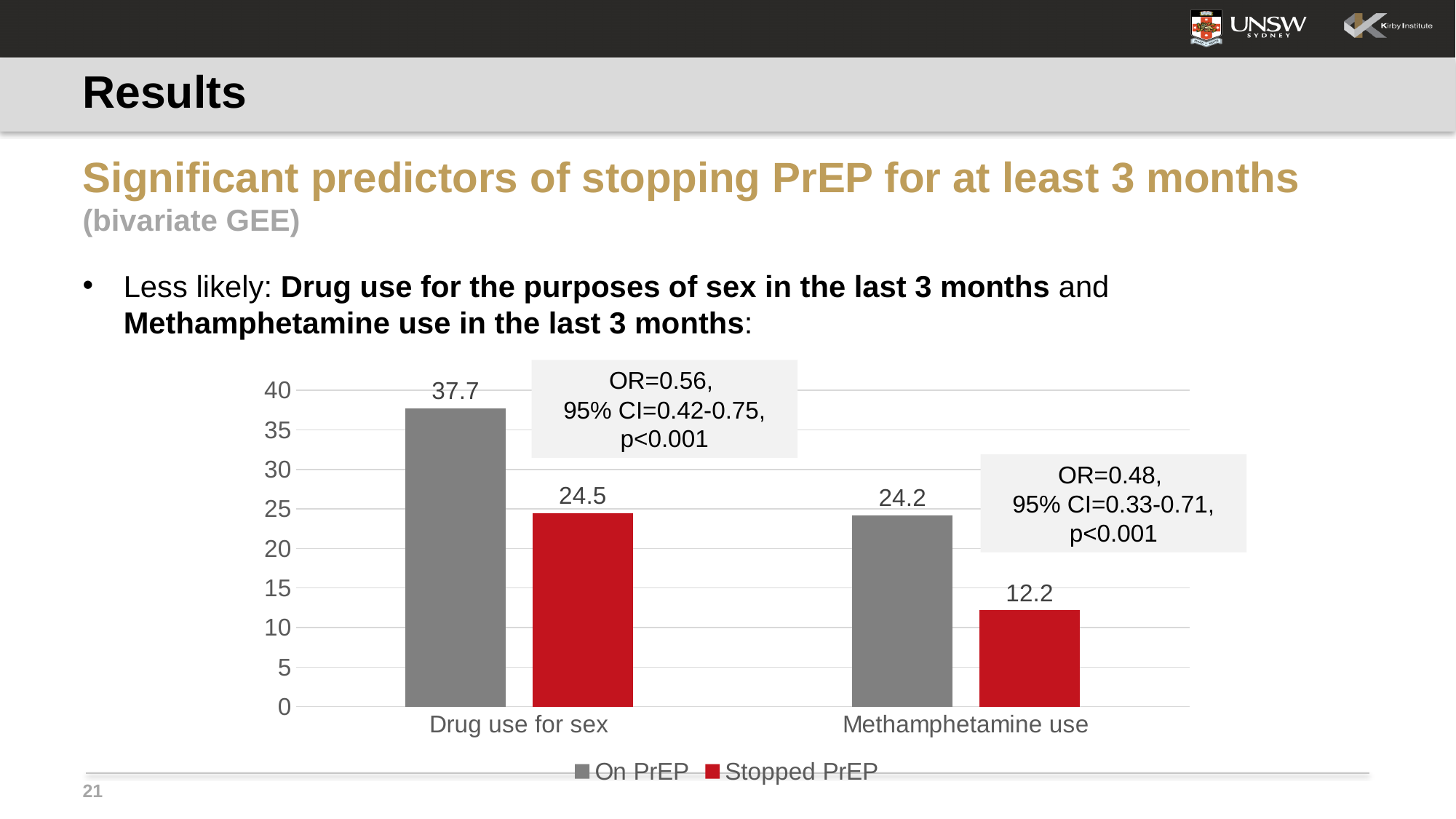
Which bar has the highest value on the chart? On PrEP, Drug use for sex What is the value for Stopped PrEP in the Methamphetamine use category? 12.2 Which bar has the lowest value on the chart? Stopped PrEP, Methamphetamine use What kind of chart is shown on the slide? Bar chart How many categories are shown on the x axis? 2 What is the value for Stopped PrEP in the Drug use for sex category? 24.5 What is the value for On PrEP in the Drug use for sex category? 37.7 How many series does the legend list? 2 What is the difference between the On PrEP and Stopped PrEP values for Drug use for sex? 13.2 What is the difference between the On PrEP and Stopped PrEP values for Methamphetamine use? 12 Which is larger: the Stopped PrEP value for Drug use for sex or the On PrEP value for Methamphetamine use? Stopped PrEP value for Drug use for sex What is the value for On PrEP in the Methamphetamine use category? 24.2